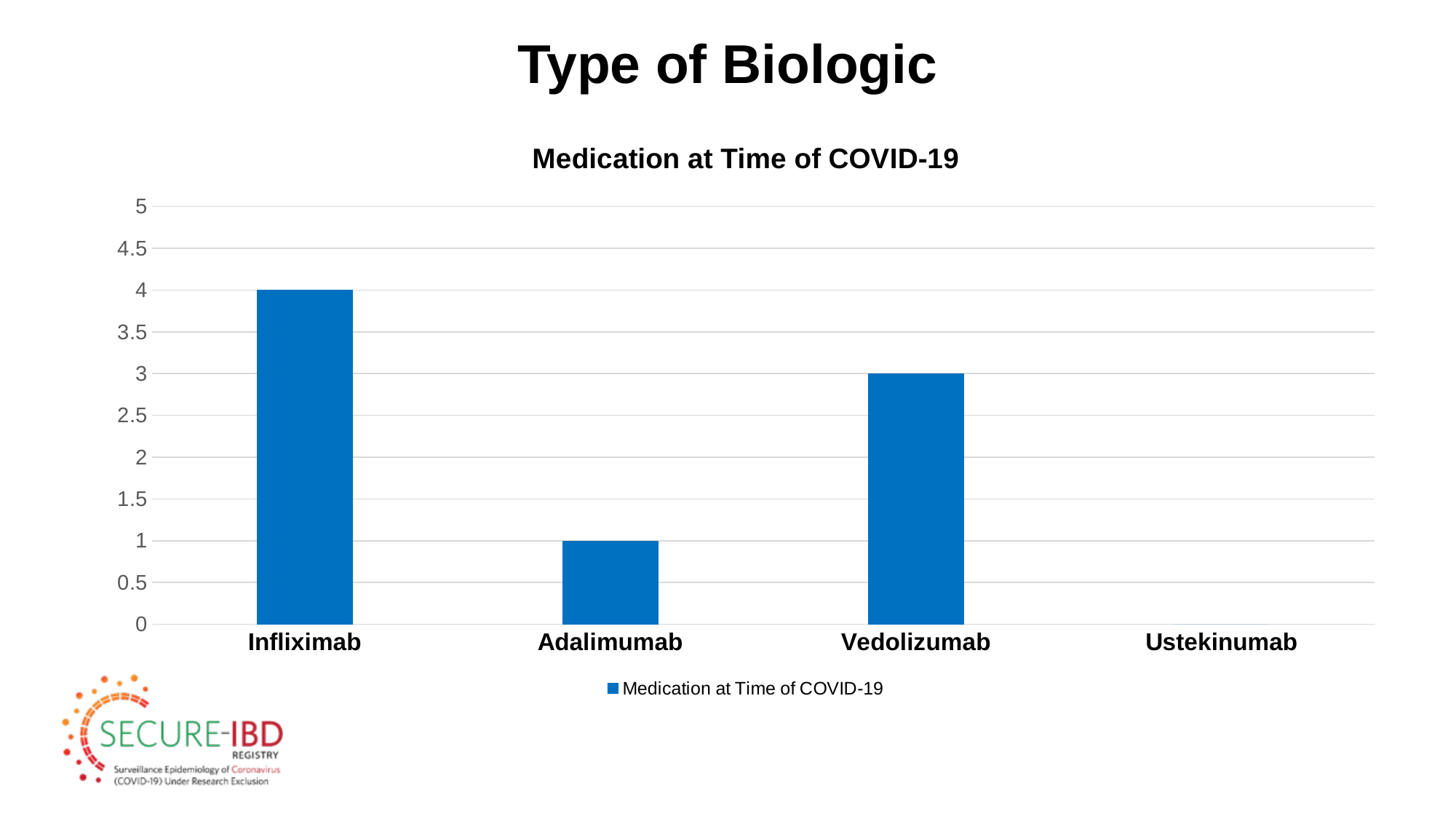
What is the title of the chart? Medication at Time of COVID-19 Is the value for Infliximab greater or less than 3.5? greater Which medication has the lowest value? Ustekinumab Which is larger, the value for Adalimumab or the value for Vedolizumab? Vedolizumab Which medication has the highest value? Infliximab What kind of chart is shown on the slide? bar chart What is the difference between the values for Vedolizumab and Adalimumab? 2 What is the value for Infliximab? 4 What is the value for Adalimumab? 1 What is the difference between the values for Infliximab and Vedolizumab? 1 How many medication categories are shown on the x axis? 4 What is the value for Vedolizumab? 3